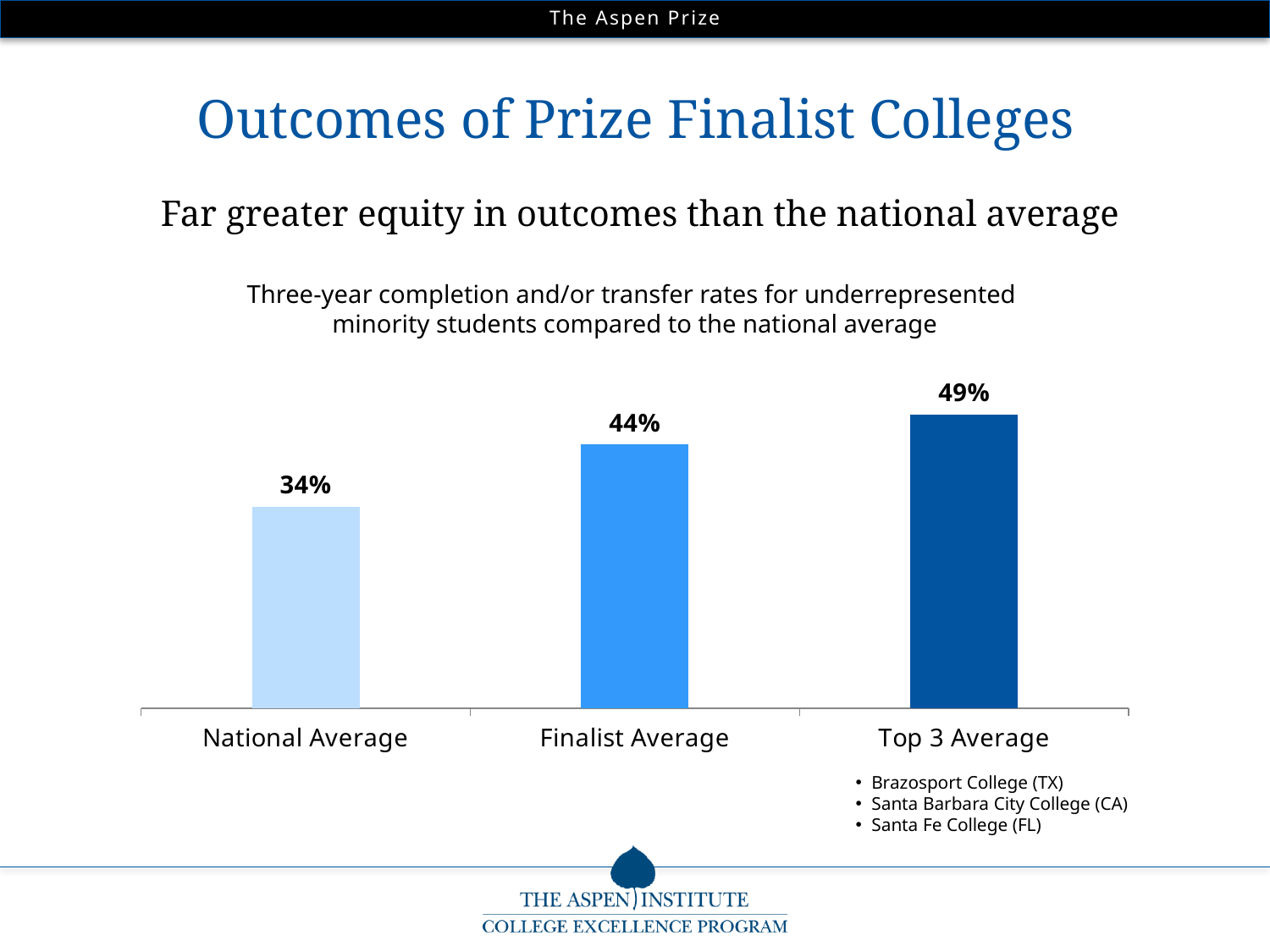
Which is larger, the Finalist Average or the National Average? Finalist Average What is the value for Finalist Average? 44% Which three colleges are listed under Top 3 Average? Brazosport College (TX), Santa Barbara City College (CA), Santa Fe College (FL) What is the value for National Average? 34% How many categories are shown in the chart? 3 Which category has the lowest value? National Average What kind of chart is shown on the slide? Bar chart What is the difference between the Top 3 Average and the National Average? 15% Which category has the highest value? Top 3 Average What is the value for Top 3 Average? 49% Do the values rise or fall from left to right across the categories? Rise What is the difference between the Finalist Average and the National Average? 10%